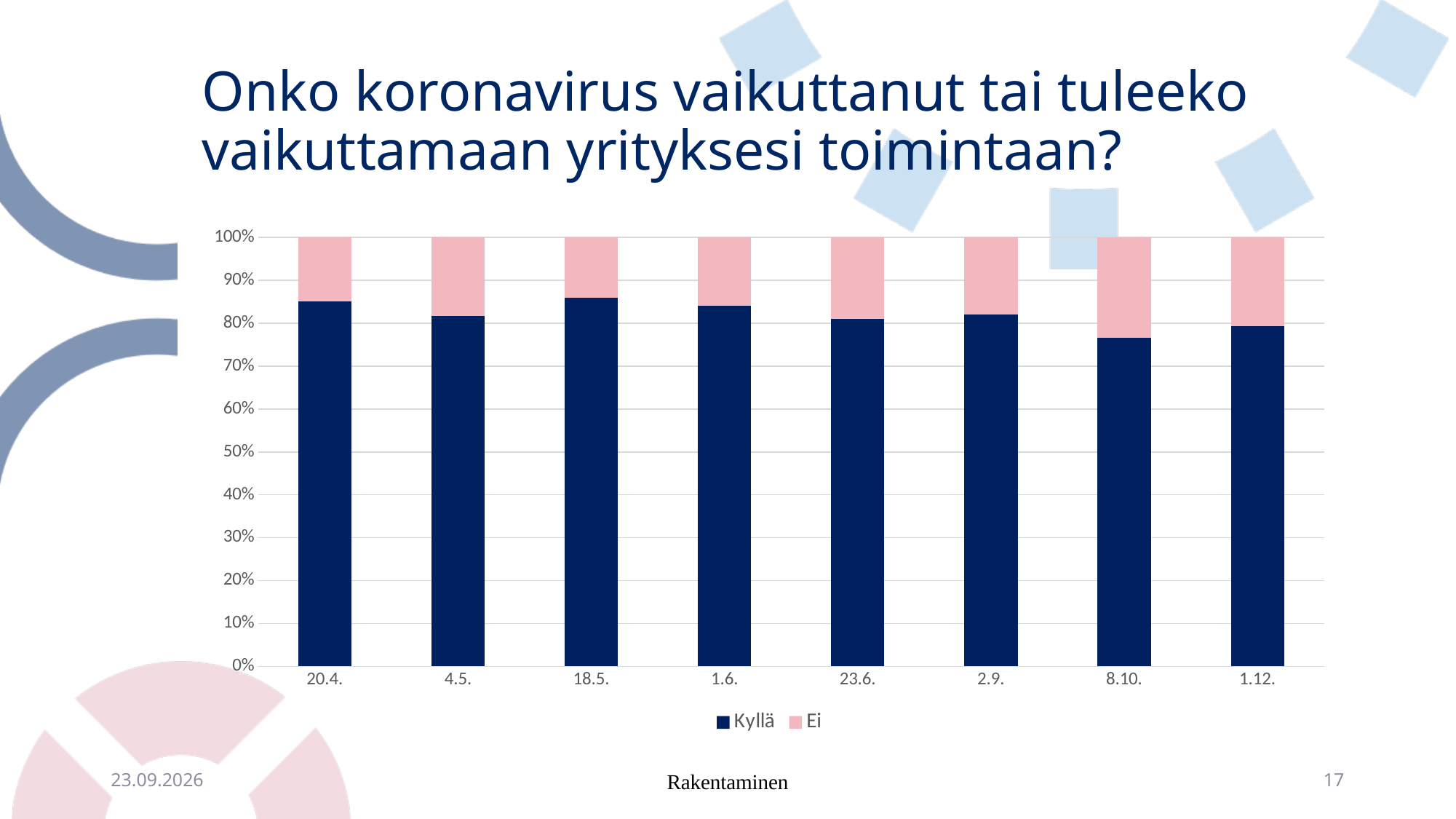
Is the Ei value for 18.5. greater or less than 20%? less How many series does the chart legend list? 2 Is the Kyllä value for 8.10. greater or less than 80%? less Which has the larger Kyllä share, 20.4. or 8.10.? 20.4. On which date is the Kyllä share the lowest? 8.10. Which series is shown in dark blue in the chart? Kyllä What is the total height of each stacked bar in the chart? 100% What kind of chart is shown on the slide? stacked bar chart Is the Ei value for 8.10. greater or less than 20%? greater What are the two series named in the chart legend? Kyllä and Ei How many dates (categories) are shown on the x axis of the chart? 8